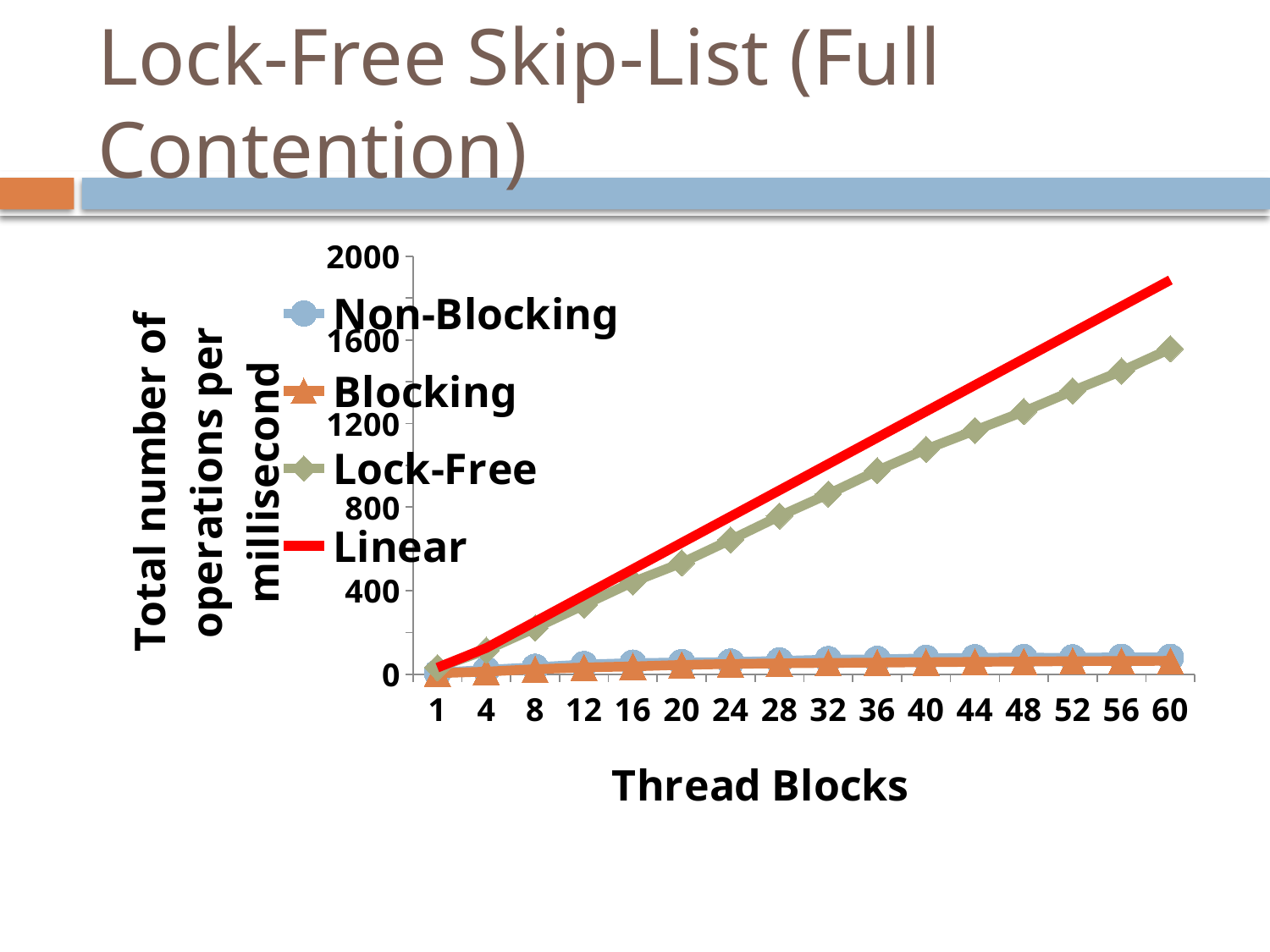
Does the Lock-Free series rise or fall as the number of thread blocks increases? rises At 60 thread blocks, which is larger: the Lock-Free value or the Non-Blocking value? Lock-Free Is the Non-Blocking value at 60 thread blocks greater or less than 400? less What is the title of the x axis? Thread Blocks Which series has the lowest value at 60 thread blocks? Blocking Is the Linear value at 60 thread blocks greater or less than 1600? greater How many thread-block values are labelled along the x axis? 16 What kind of chart is shown on the slide? line chart How many series does the legend list? 4 Is the Lock-Free value at 32 thread blocks greater or less than 400? greater Which series has the highest value at 60 thread blocks? Linear